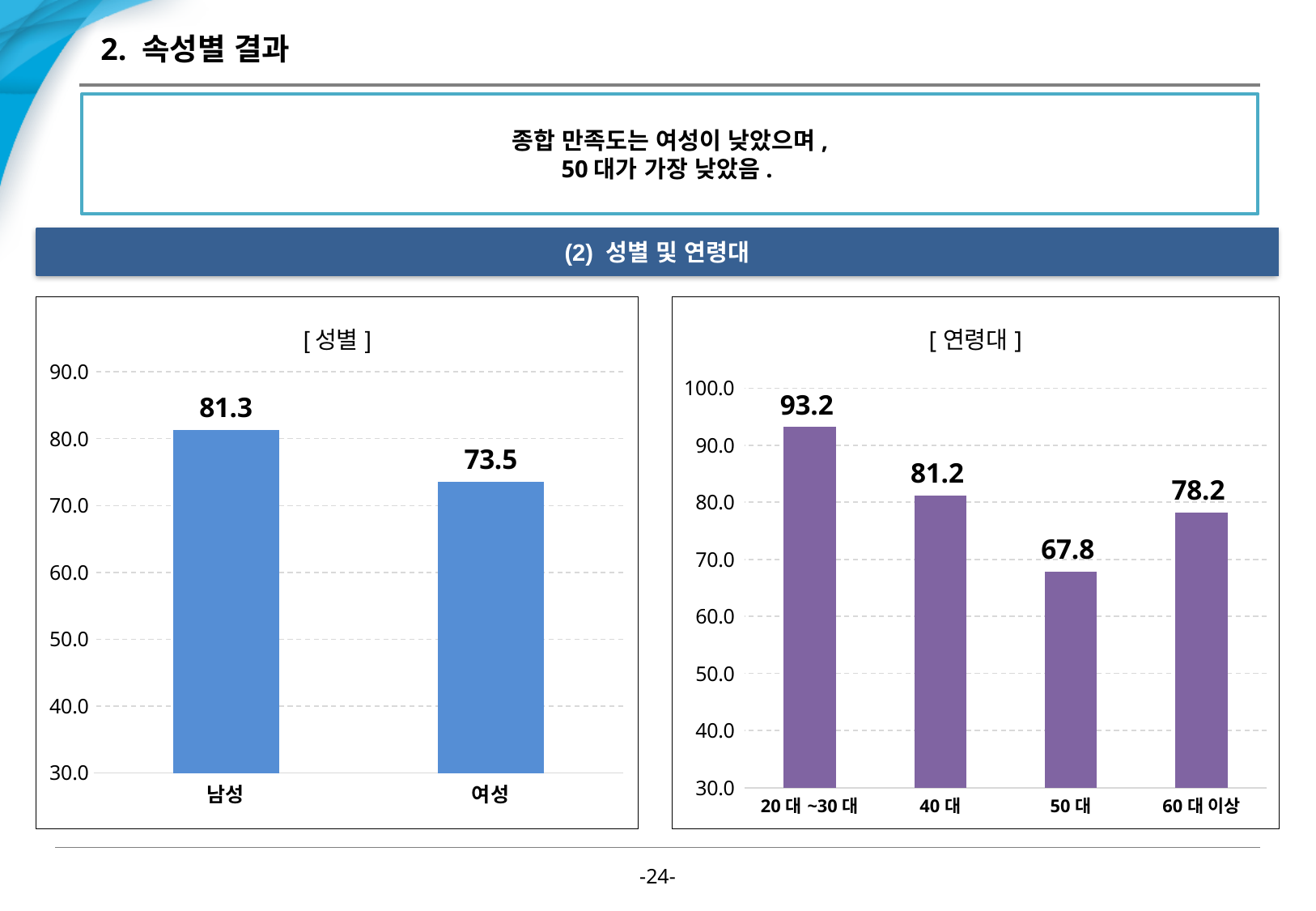
In the [성별] chart, which category has the lower value? 여성 In the [연령대] chart, what is the difference between the values for 20 대 ~30 대 and 50 대? 25.4 In the [성별] chart, what is the value for 여성? 73.5 In the [성별] chart, what is the value for 남성? 81.3 In the [연령대] chart, what is the value for 60 대 이상? 78.2 In the [연령대] chart, what is the value for 50 대? 67.8 In the [성별] chart, what is the difference between the values for 남성 and 여성? 7.8 In the [연령대] chart, which age group has the highest value? 20 대 ~30 대 In the [연령대] chart, which age group has the lowest value? 50 대 In the [연령대] chart, which is larger, the value for 40 대 or the value for 60 대 이상? 40 대 How many age groups are shown in the [연령대] chart? 4 What type of chart is the [성별] chart? Bar chart